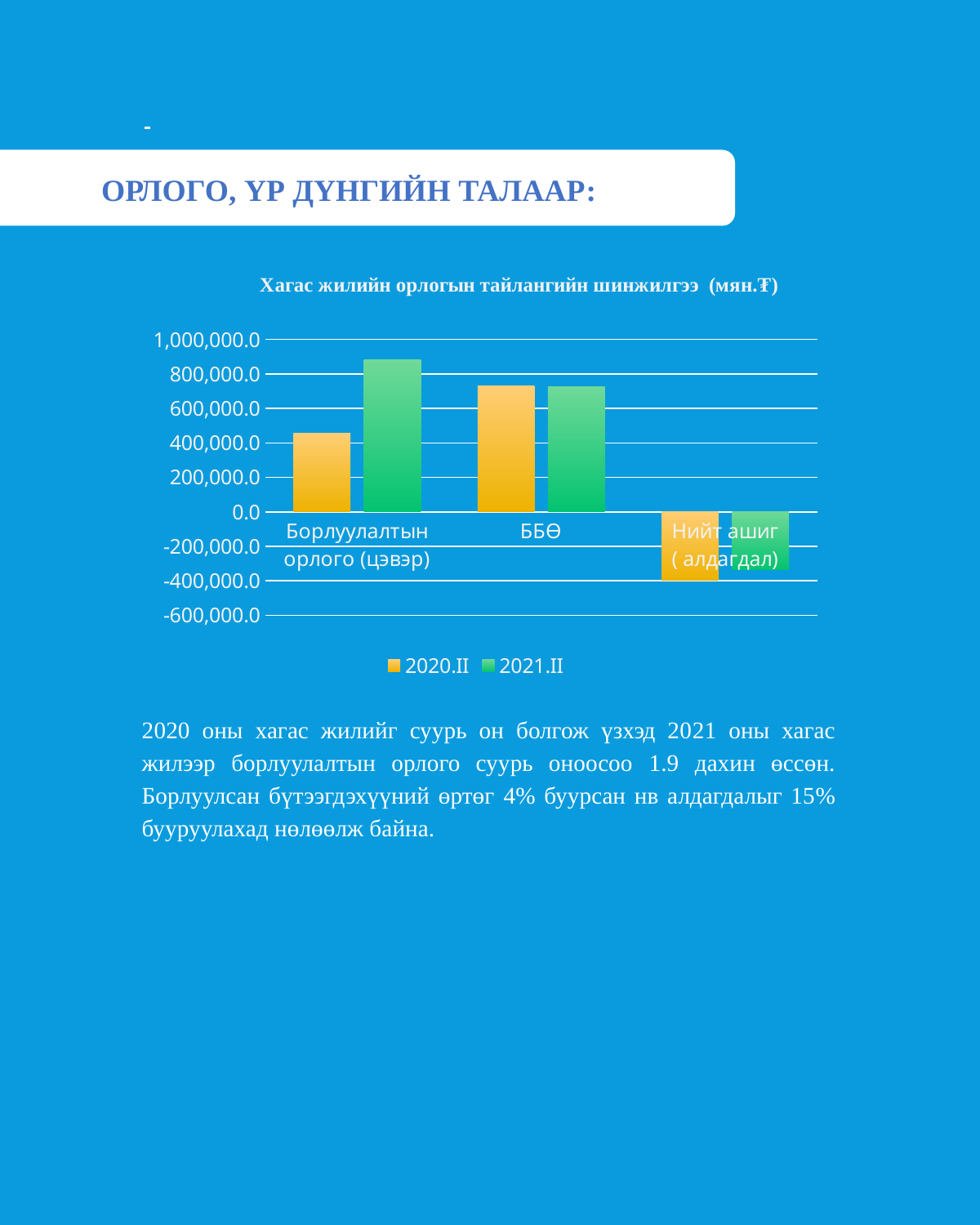
What kind of chart is shown on the slide? bar chart Is the 2021.II value for Борлуулалтын орлого (цэвэр) greater or less than 800,000.0? greater How many series does the chart legend list? 2 Which category has the lowest 2020.II value? Нийт ашиг (алдагдал) Which category has the highest 2021.II value? Борлуулалтын орлого (цэвэр) What is the title of the chart? Хагас жилийн орлогын тайлангийн шинжилгээ (мян.₮) Is the 2021.II value for Нийт ашиг (алдагдал) greater or less than -200,000.0? less Is the 2020.II value for ББӨ greater or less than 600,000.0? greater Which series is larger for Борлуулалтын орлого (цэвэр), 2020.II or 2021.II? 2021.II How many categories are shown on the x axis of the chart? 3